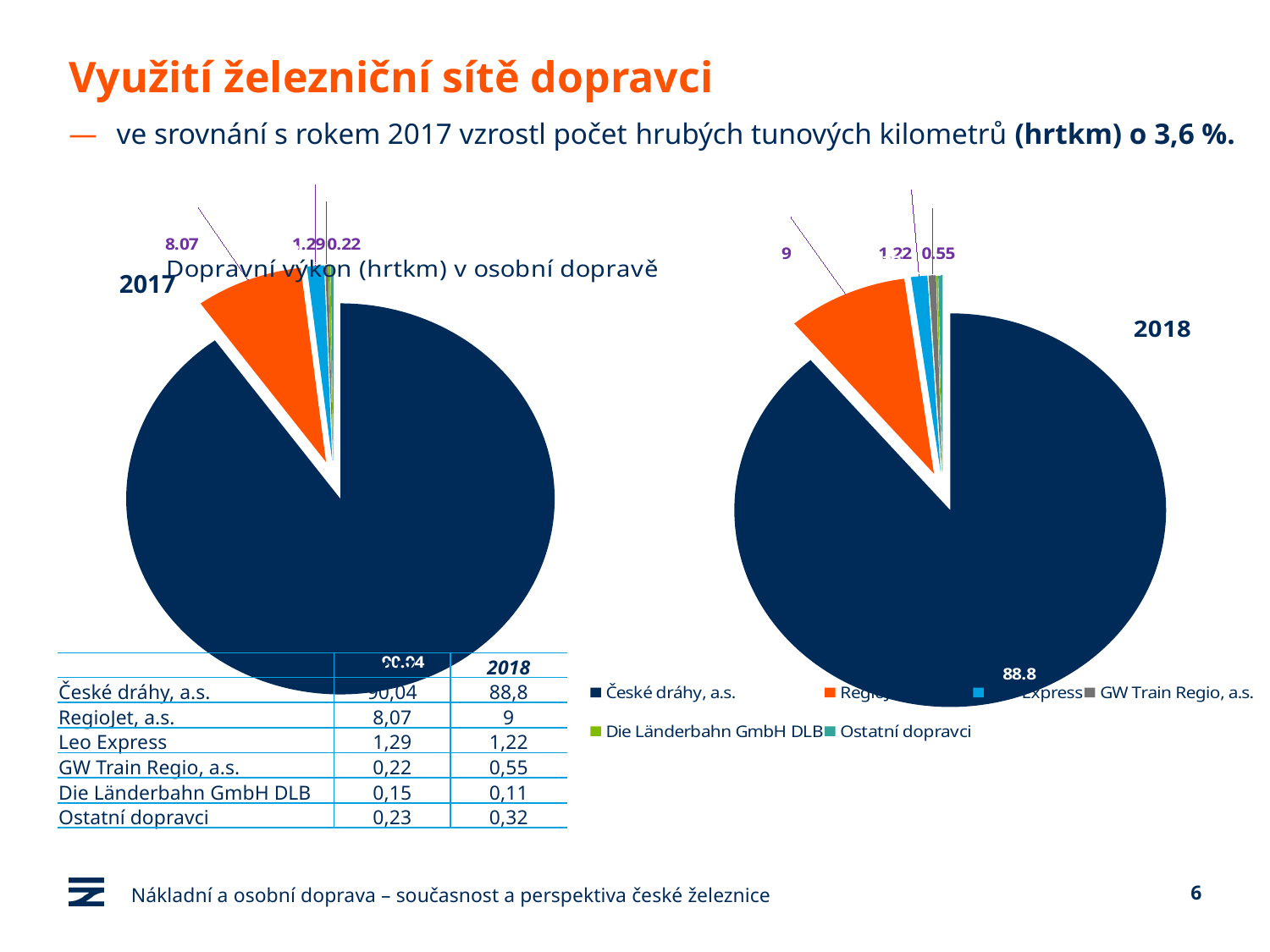
How many entries does the shared legend of the pie charts list? 6 In the 2018 pie chart, what is the value shown for the largest slice (České dráhy, a.s.)? 88.8 In the 2018 pie chart, what is the value shown for the GW Train Regio, a.s. slice? 0.55 Which carrier has the largest slice in the 2017 pie chart? České dráhy, a.s. In the 2018 pie chart, which slice is larger: RegioJet, a.s. or Leo Express? RegioJet, a.s. What is the difference between the RegioJet, a.s. value in the 2018 pie chart (9) and in the 2017 pie chart (8.07)? 0.93 In the 2018 pie chart, what is the value shown for the RegioJet, a.s. slice? 9 In the 2017 pie chart, what is the value shown for the Leo Express slice? 1.29 Which colour is used for the České dráhy, a.s. slice in the pie charts? dark blue What kind of chart is used to show the 2018 data on the slide? pie chart In the 2017 pie chart, what is the value shown for the RegioJet, a.s. slice? 8.07 What is the title printed above the pie charts? Dopravní výkon (hrtkm) v osobní dopravě